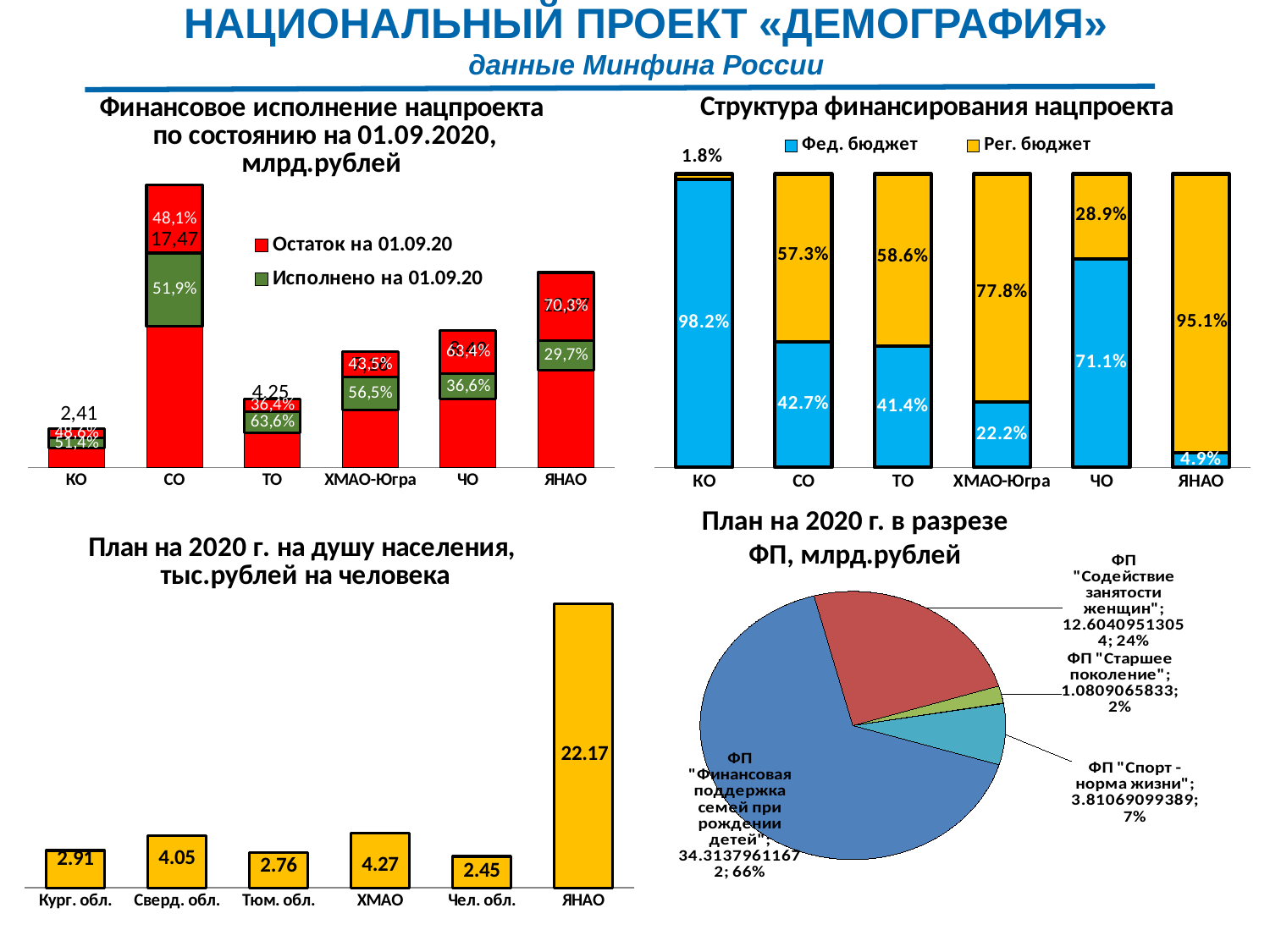
In the chart 'План на 2020 г. на душу населения, тыс.рублей на человека', which region has the lowest value? Чел. обл. In the chart 'Структура финансирования нацпроекта', which region has the highest share of Рег. бюджет? ЯНАО In the chart 'Структура финансирования нацпроекта', how many series does the legend list? 2 In the chart 'Финансовое исполнение нацпроекта по состоянию на 01.09.2020, млрд.рублей', what percentage is labelled 'Исполнено на 01.09.20' for ЯНАО? 29,7% In the pie chart 'План на 2020 г. в разрезе ФП, млрд.рублей', what share does ФП "Содействие занятости женщин" have? 24% In the chart 'План на 2020 г. на душу населения, тыс.рублей на человека', how many regions are shown? 6 In the chart 'План на 2020 г. на душу населения, тыс.рублей на человека', what is the difference between the values for ХМАО and Сверд. обл.? 0.22 What type of chart is 'План на 2020 г. в разрезе ФП, млрд.рублей'? Pie chart In the chart 'Структура финансирования нацпроекта', is the Фед. бюджет share larger for СО or for ЧО? ЧО In the chart 'План на 2020 г. на душу населения, тыс.рублей на человека', what is the value for ЯНАО? 22.17 In the chart 'Финансовое исполнение нацпроекта по состоянию на 01.09.2020, млрд.рублей', what is the total value shown for СО? 17,47 In the chart 'Структура финансирования нацпроекта', what is the share of Фед. бюджет for ХМАО-Югра? 22.2%